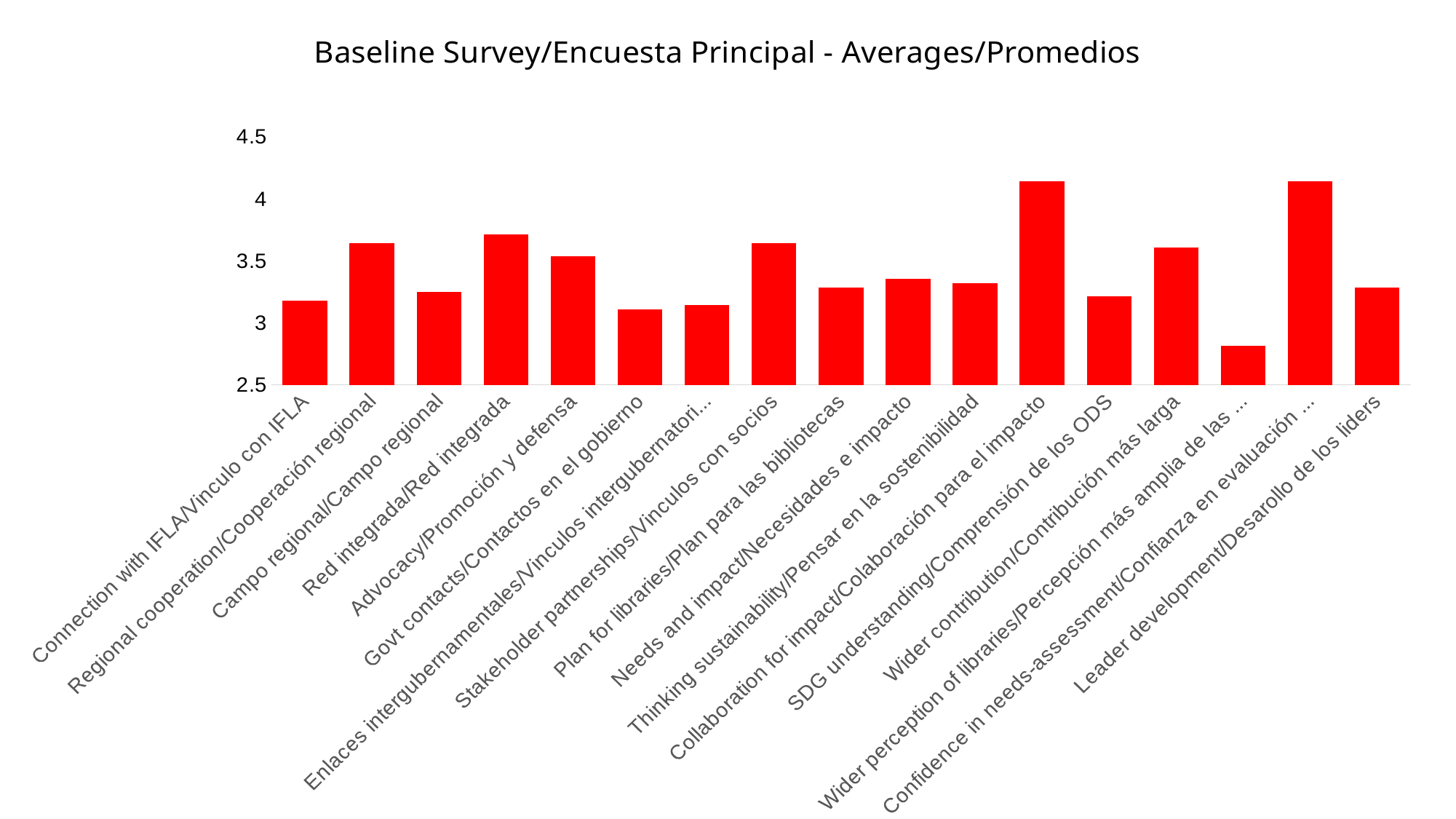
What is the title of the chart? Baseline Survey/Encuesta Principal - Averages/Promedios What kind of chart is shown on the slide? bar chart Is the value for Wider perception of libraries/Percepción más amplia de las ... greater or less than 3? less Which is larger, the value for Advocacy/Promoción y defensa or the value for Govt contacts/Contactos en el gobierno? Advocacy/Promoción y defensa Is the value for Connection with IFLA/Vinculo con IFLA greater or less than 3.5? less How many categories are plotted on the x axis? 17 Which is larger, the value for Red integrada/Red integrada or the value for Connection with IFLA/Vinculo con IFLA? Red integrada/Red integrada Is the value for Collaboration for impact/Colaboración para el impacto greater or less than 4? greater Which category has the lowest average? Wider perception of libraries/Percepción más amplia de las ... What colour are the bars in the chart? red